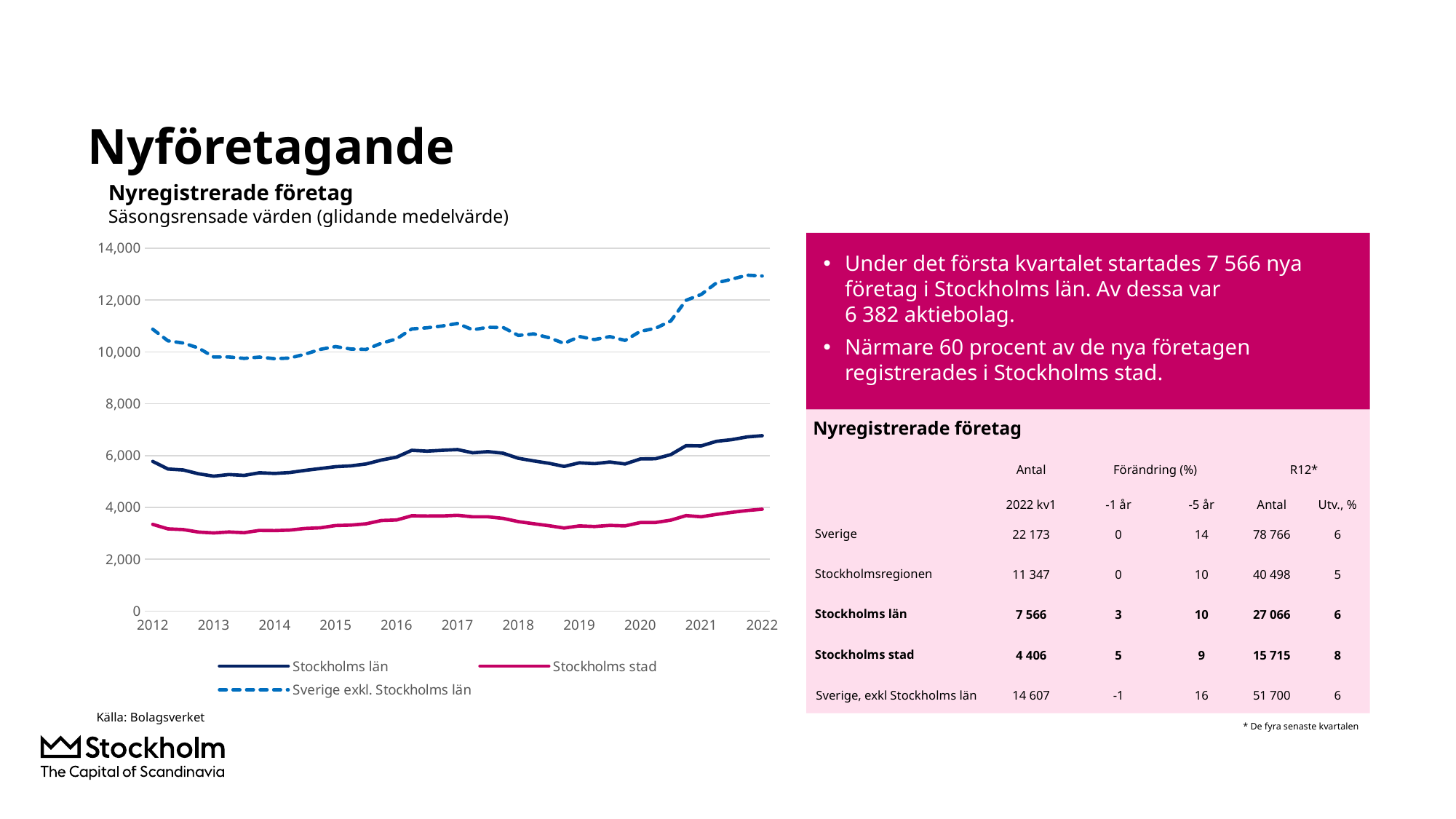
Which series in the chart is drawn with a dashed line? Sverige exkl. Stockholms län What is the title of the chart? Nyregistrerade företag Is the value for Sverige exkl. Stockholms län in 2012 greater or less than 10,000? greater In 2022, which is larger: Stockholms län or Stockholms stad? Stockholms län Does the Sverige exkl. Stockholms län series rise or fall between 2020 and 2022? Rise Is the value for Stockholms län in 2022 greater or less than 6,000? greater Is the value for Sverige exkl. Stockholms län in 2022 greater or less than 12,000? greater Which series has the highest values throughout the chart? Sverige exkl. Stockholms län Which series has the lowest values throughout the chart? Stockholms stad What kind of chart is shown on the slide? Line chart How many series does the chart legend list? 3